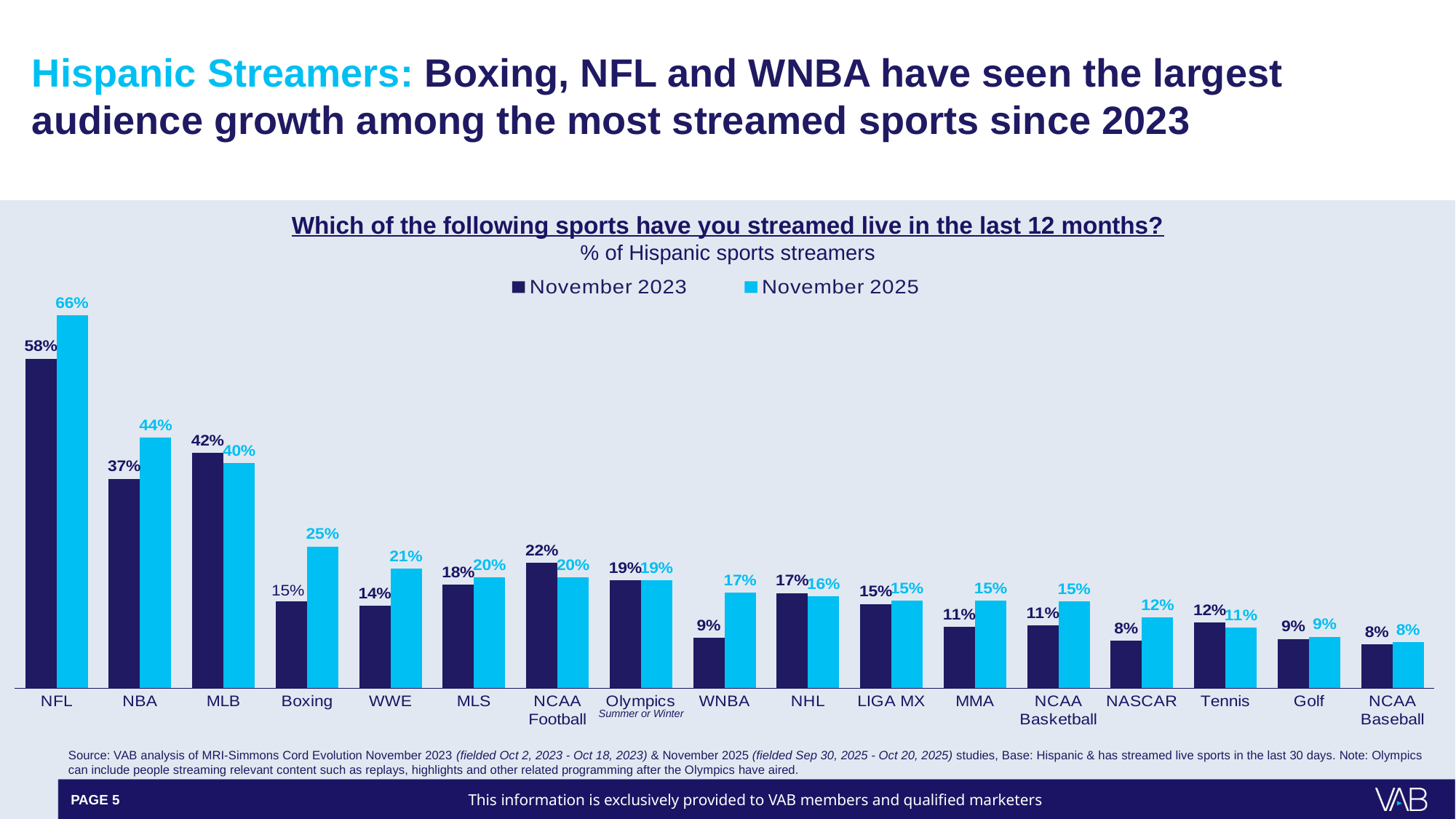
What is the November 2023 value for Boxing? 15% What is the November 2025 value for WNBA? 17% How many series does the legend list? 2 What is the November 2025 value for NFL? 66% What is the difference between the November 2025 values for NFL and NBA? 22 percentage points What are the two series listed in the legend? November 2023 and November 2025 Which is larger for MLB: the November 2023 value or the November 2025 value? November 2023 Which sport has the lowest November 2023 value? NASCAR and NCAA Baseball (both 8%) What is the difference between the November 2025 and November 2023 values for Boxing? 10 percentage points Which sport has the highest November 2025 value? NFL What kind of chart is shown on the slide? Bar chart How many sports categories are shown on the chart? 17